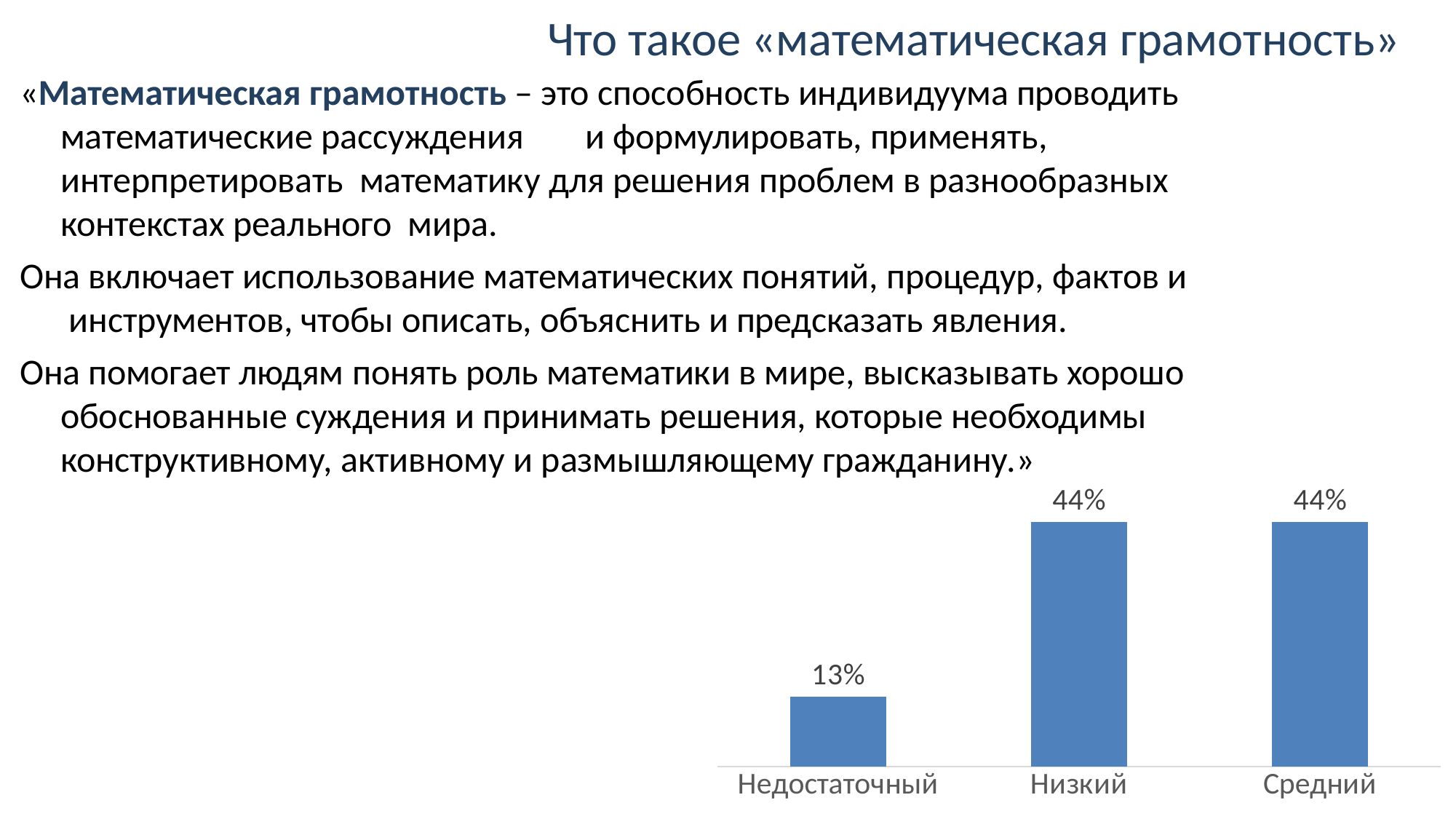
What colour are the bars in the chart? Blue What is the value for Низкий? 44% Does the value rise or fall from Недостаточный to Низкий? Rise What is the value for Средний? 44% Which category has the lowest value? Недостаточный What is the value for Недостаточный? 13% What is the difference between the values for Низкий and Недостаточный? 31% Which is larger, the value for Недостаточный or the value for Средний? Средний What is the difference between the values for Средний and Недостаточный? 31% What kind of chart is shown on the slide? Bar chart Which is larger, the value for Низкий or the value for Недостаточный? Низкий How many categories are shown in the chart? 3